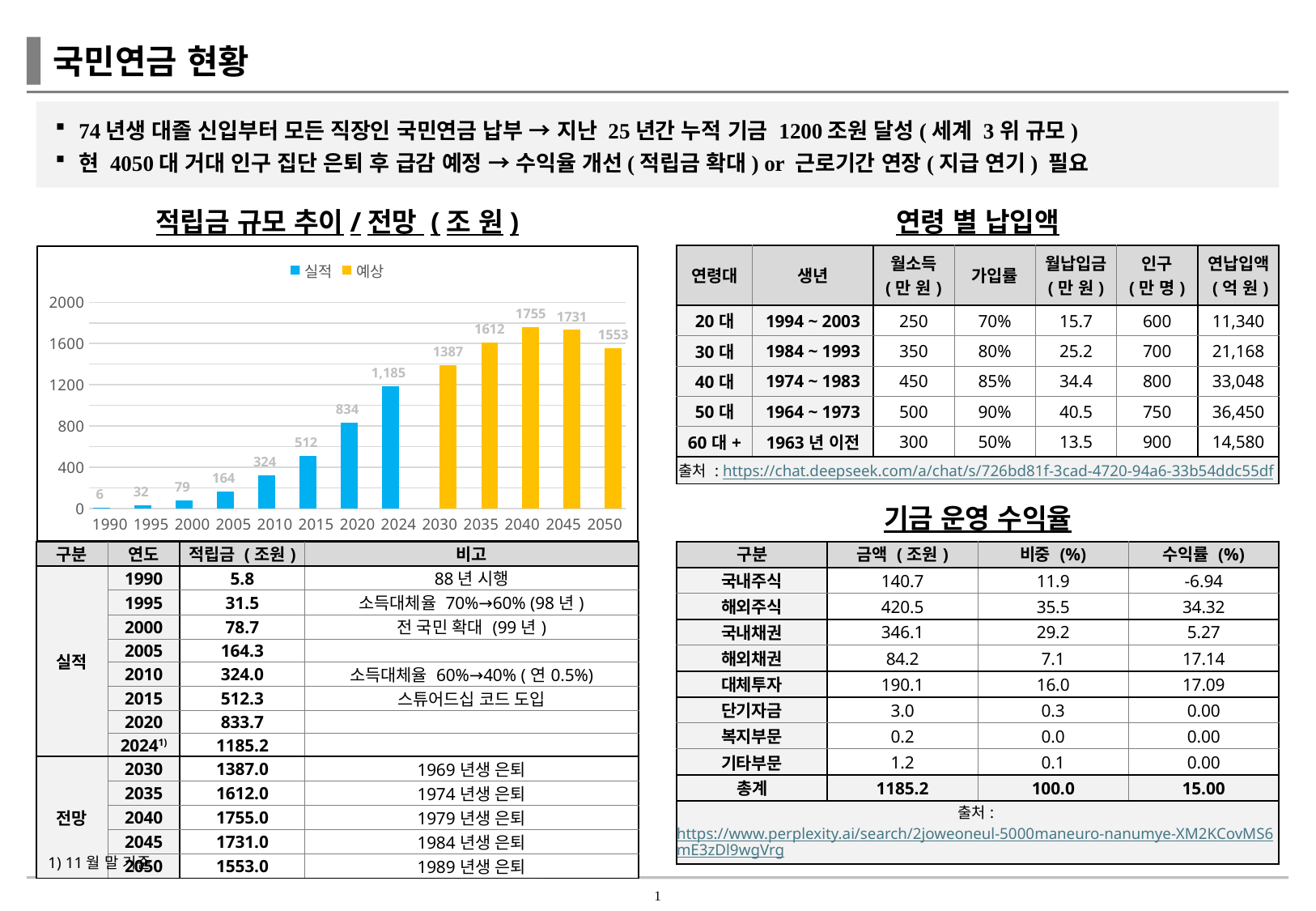
In the '적립금 규모 추이 / 전망' chart, what is the data label for 2050? 1553 How many years are shown on the x axis of the '적립금 규모 추이 / 전망' chart? 13 In the '적립금 규모 추이 / 전망' chart, do the values rise or fall from 1990 to 2040? rise In the '적립금 규모 추이 / 전망' chart, what is the difference between the 2040 value and the 2045 value? 24 In the '적립금 규모 추이 / 전망' chart, which series is shown in yellow? 예상 Which year has the highest bar in the '적립금 규모 추이 / 전망' chart? 2040 How many series does the legend of the '적립금 규모 추이 / 전망' chart list? 2 Which year has the lowest bar in the '적립금 규모 추이 / 전망' chart? 1990 In the '적립금 규모 추이 / 전망' chart, what is the data label for 2015? 512 What type of chart is shown under the title '적립금 규모 추이 / 전망 (조 원)'? bar chart In the '적립금 규모 추이 / 전망' chart, which is larger, the value for 2030 or the value for 2035? 2035 In the '적립금 규모 추이 / 전망' chart, what is the data label for 2024? 1,185